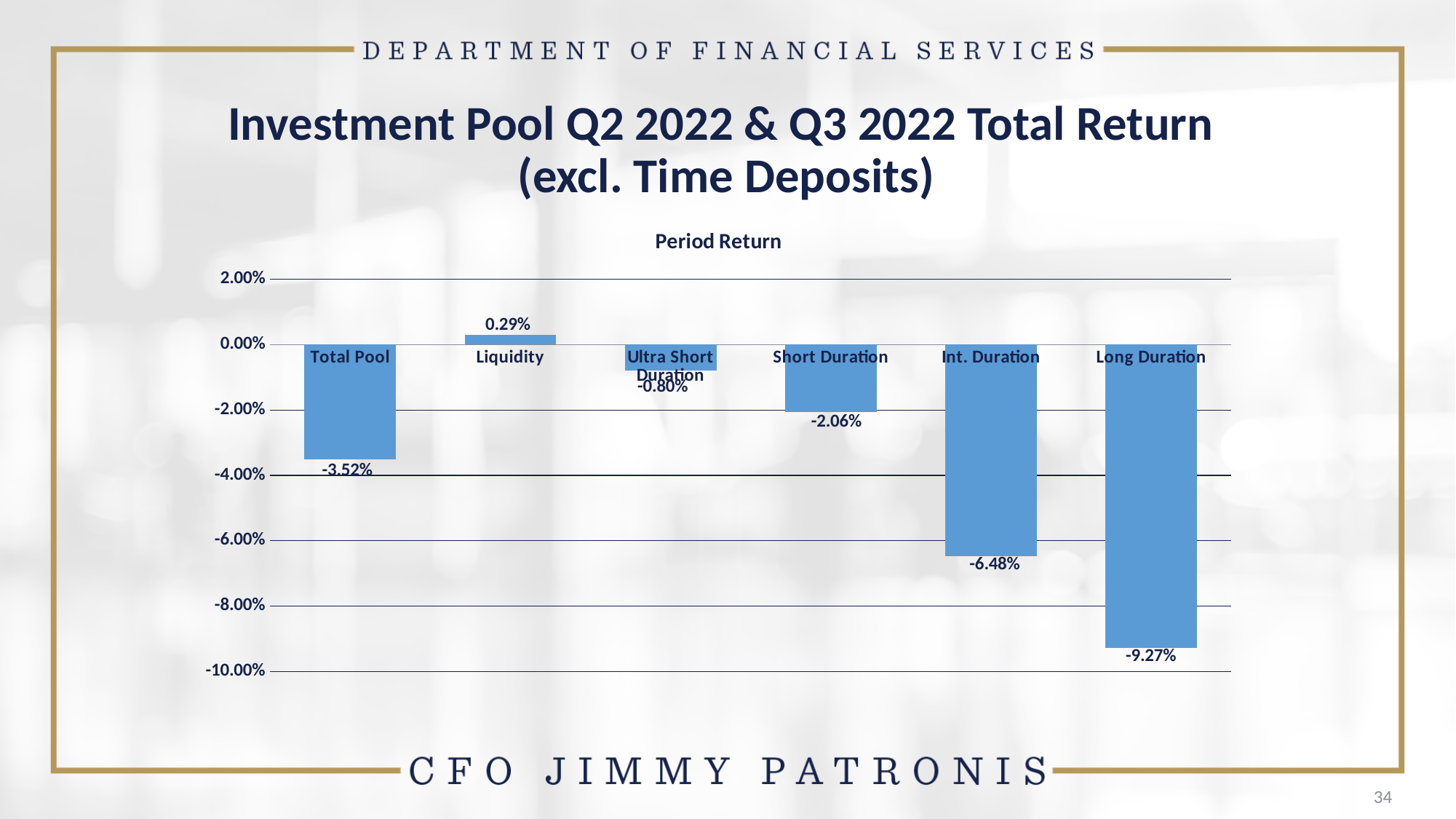
Which has a higher period return, Short Duration or Ultra Short Duration? Ultra Short Duration Which category has the lowest period return? Long Duration What is the period return for Liquidity? 0.29% What kind of chart is shown on the slide? Bar chart Is the period return for Short Duration greater or less than -2.00%? less What is the title of the chart? Period Return What is the difference between the period returns of Int. Duration and Long Duration? 2.79% How many categories are shown in the chart? 6 What is the period return for Int. Duration? -6.48% Which category has the highest period return? Liquidity What is the period return for Long Duration? -9.27% What is the period return for Total Pool? -3.52%